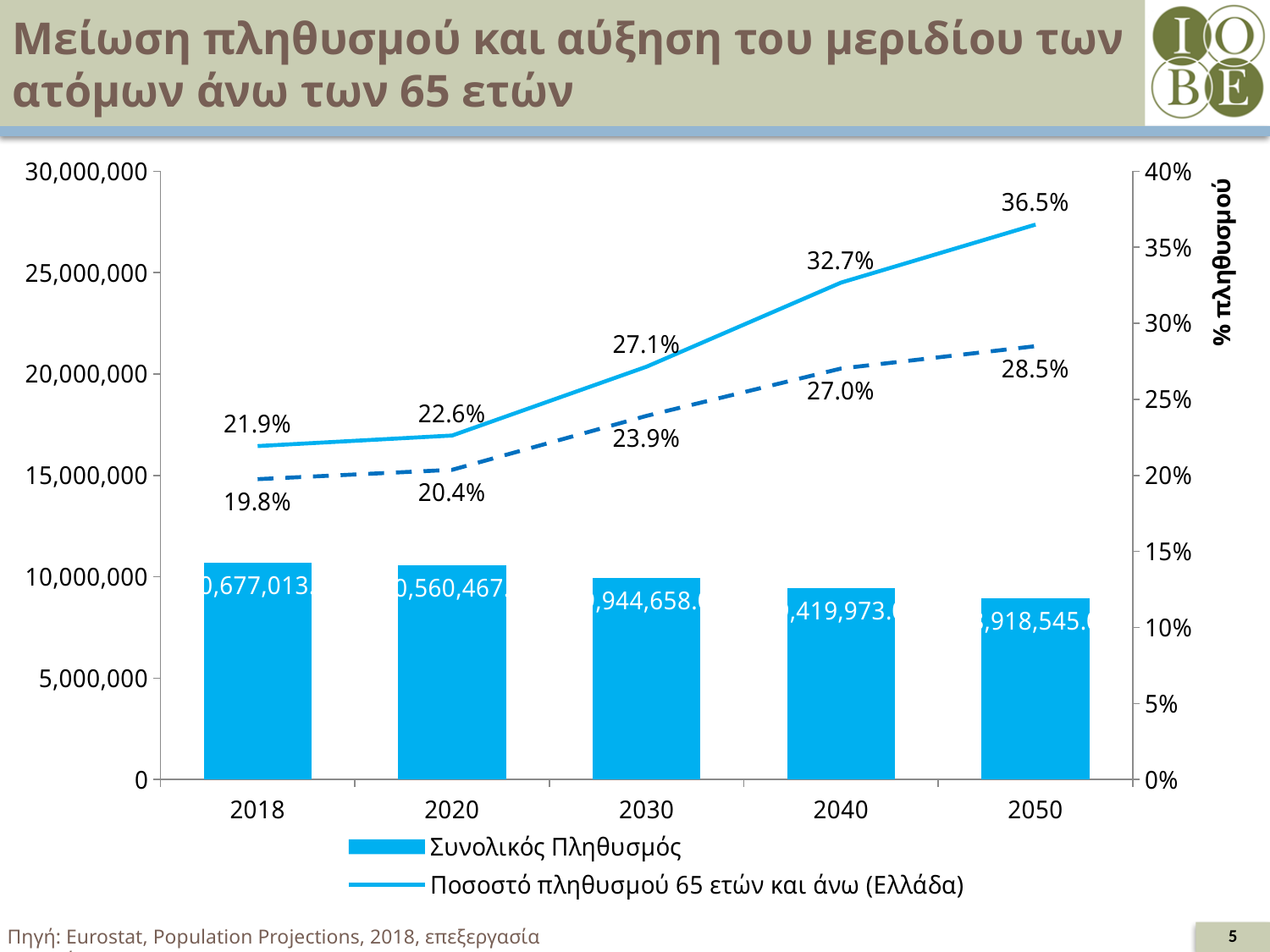
Does the 'Ποσοστό πληθυσμού 65 ετών και άνω (Ελλάδα)' line rise or fall from 2018 to 2050? rise Is the 'Συνολικός Πληθυσμός' bar for 2018 greater or less than 10,000,000? greater What is the value of the 'Ποσοστό πληθυσμού 65 ετών και άνω (Ελλάδα)' line for 2030? 27.1% How many series does the chart legend list? 2 What is the value of the 'Ποσοστό πληθυσμού 65 ετών και άνω (Ελλάδα)' line for 2018? 21.9% Which year has the larger 'Ποσοστό πληθυσμού 65 ετών και άνω (Ελλάδα)' value, 2020 or 2040? 2040 What is the value of the 'Ποσοστό πληθυσμού 65 ετών και άνω (Ελλάδα)' line for 2050? 36.5% Is the 'Συνολικός Πληθυσμός' bar for 2050 greater or less than 10,000,000? less In which year is the 'Ποσοστό πληθυσμού 65 ετών και άνω (Ελλάδα)' line lowest? 2018 By how many percentage points does the 'Ποσοστό πληθυσμού 65 ετών και άνω (Ελλάδα)' value in 2050 exceed the value in 2018? 14.6 percentage points In which year is the 'Ποσοστό πληθυσμού 65 ετών και άνω (Ελλάδα)' line highest? 2050 How many years are shown on the x axis of the chart? 5